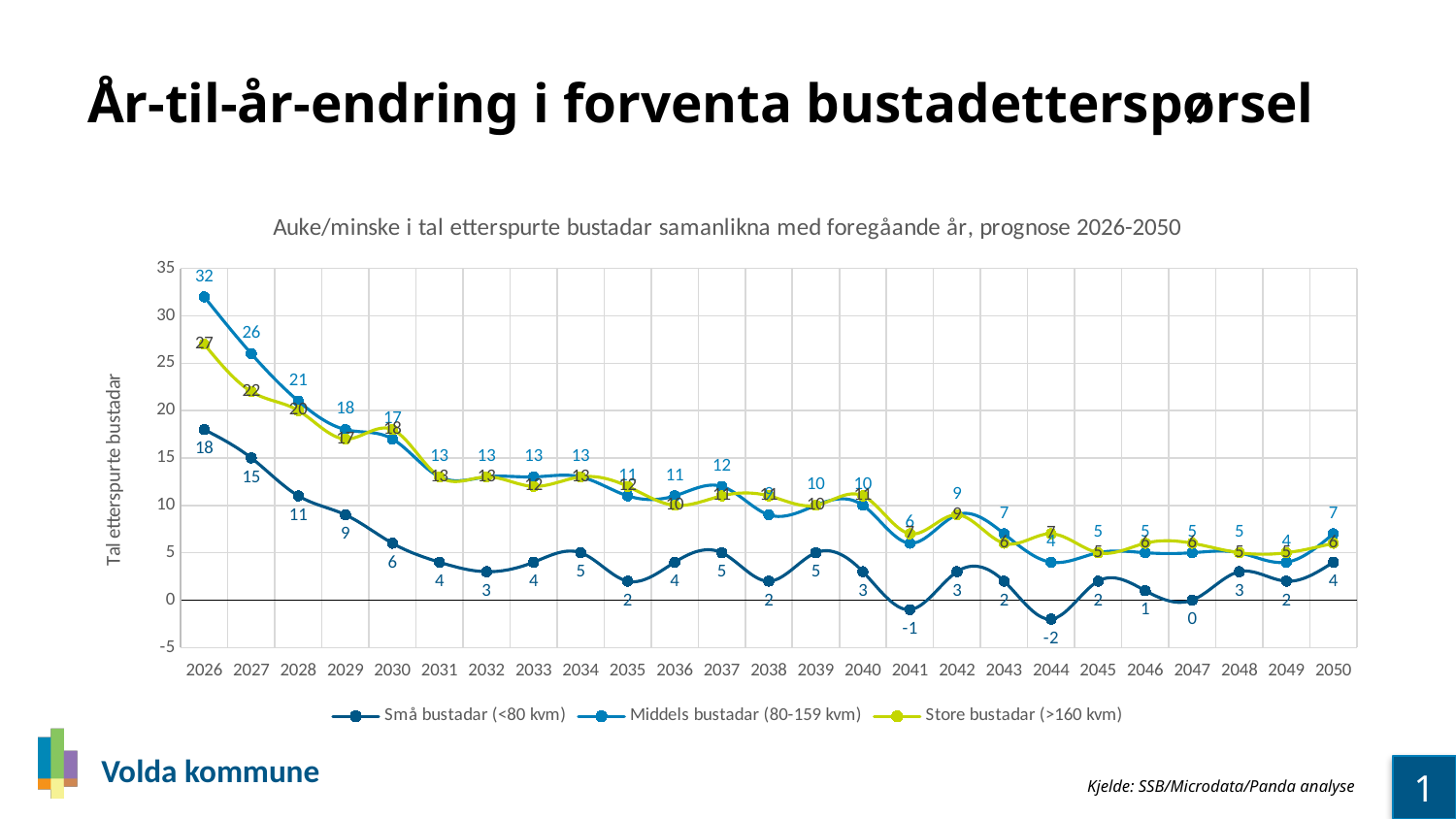
How many series does the legend list? 3 What kind of chart is shown on the slide? line chart Which series has the larger value in 2027: Middels bustadar (80-159 kvm) or Små bustadar (<80 kvm)? Middels bustadar (80-159 kvm) Does the Middels bustadar (80-159 kvm) series generally rise or fall from 2026 to 2050? fall How many years are plotted on the x axis? 25 What is the title of the vertical axis? Tal etterspurte bustadar What is the difference between Middels bustadar (80-159 kvm) and Små bustadar (<80 kvm) in 2026? 14 In which year is the value for Middels bustadar (80-159 kvm) highest? 2026 What is the value for Små bustadar (<80 kvm) in 2044? -2 In which year is the value for Små bustadar (<80 kvm) lowest? 2044 What is the value for Små bustadar (<80 kvm) in 2047? 0 What is the value for Middels bustadar (80-159 kvm) in 2026? 32